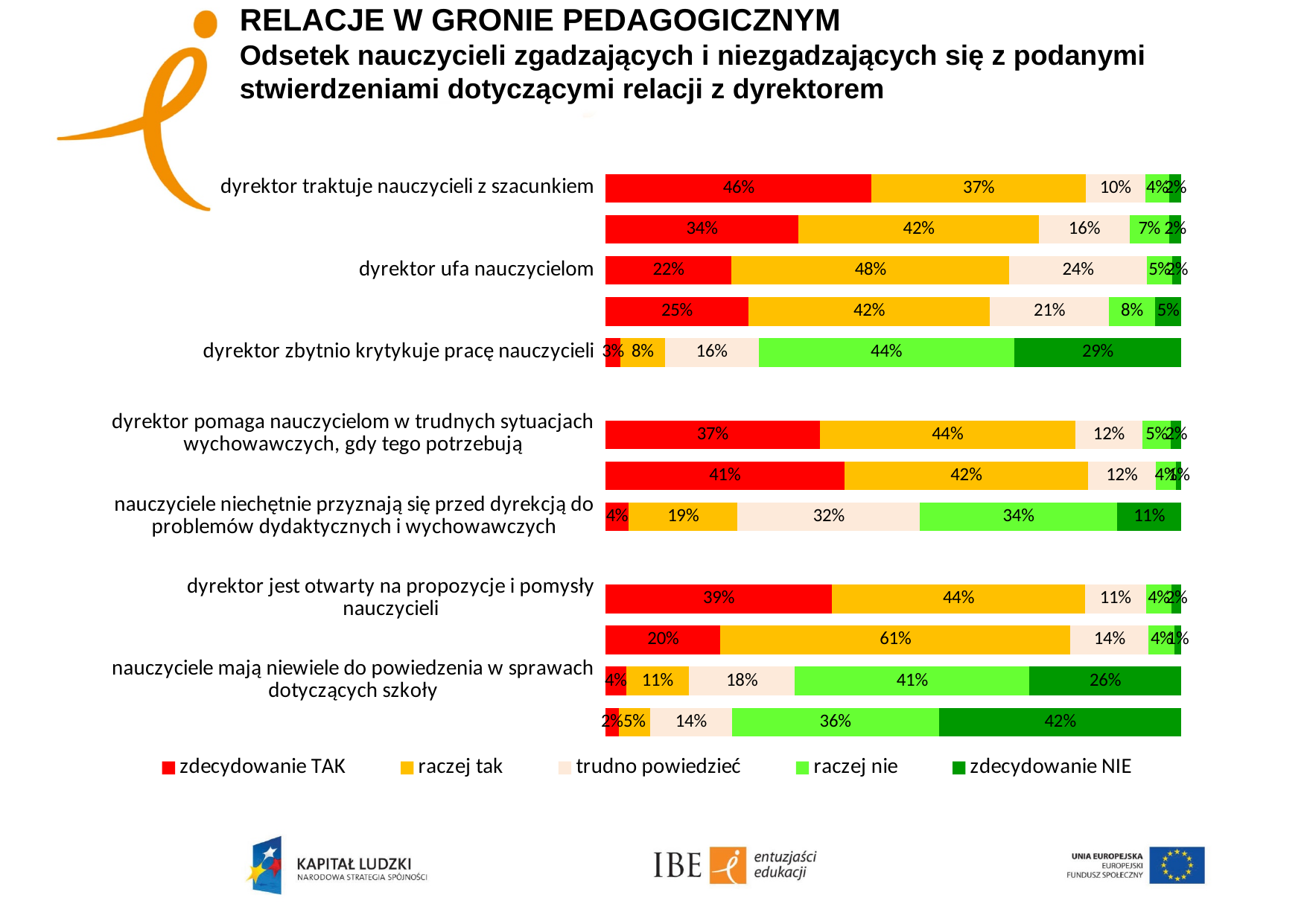
What is the difference between the "zdecydowanie TAK" shares for "dyrektor traktuje nauczycieli z szacunkiem" and "dyrektor ufa nauczycielom"? 24 percentage points What kind of chart is shown on the slide? Stacked bar chart For "dyrektor jest otwarty na propozycje i pomysły nauczycieli", which response category has the largest share? raczej tak What percentage of teachers answered "zdecydowanie NIE" to "dyrektor zbytnio krytykuje pracę nauczycieli"? 29% Which is larger: the "raczej tak" share for "dyrektor pomaga nauczycielom w trudnych sytuacjach wychowawczych, gdy tego potrzebują" or the "raczej tak" share for "dyrektor traktuje nauczycieli z szacunkiem"? dyrektor pomaga nauczycielom w trudnych sytuacjach wychowawczych, gdy tego potrzebują For "dyrektor zbytnio krytykuje pracę nauczycieli", which response category has the smallest share? zdecydowanie TAK How many response categories does the legend list? 5 What percentage of teachers answered "trudno powiedzieć" to "nauczyciele niechętnie przyznają się przed dyrekcją do problemów dydaktycznych i wychowawczych"? 32% Which colour represents "trudno powiedzieć" in the legend? Light beige What percentage of teachers answered "zdecydowanie TAK" to "dyrektor traktuje nauczycieli z szacunkiem"? 46% What percentage of teachers answered "raczej tak" to "dyrektor ufa nauczycielom"? 48% What percentage of teachers answered "raczej nie" to "nauczyciele mają niewiele do powiedzenia w sprawach dotyczących szkoły"? 41%